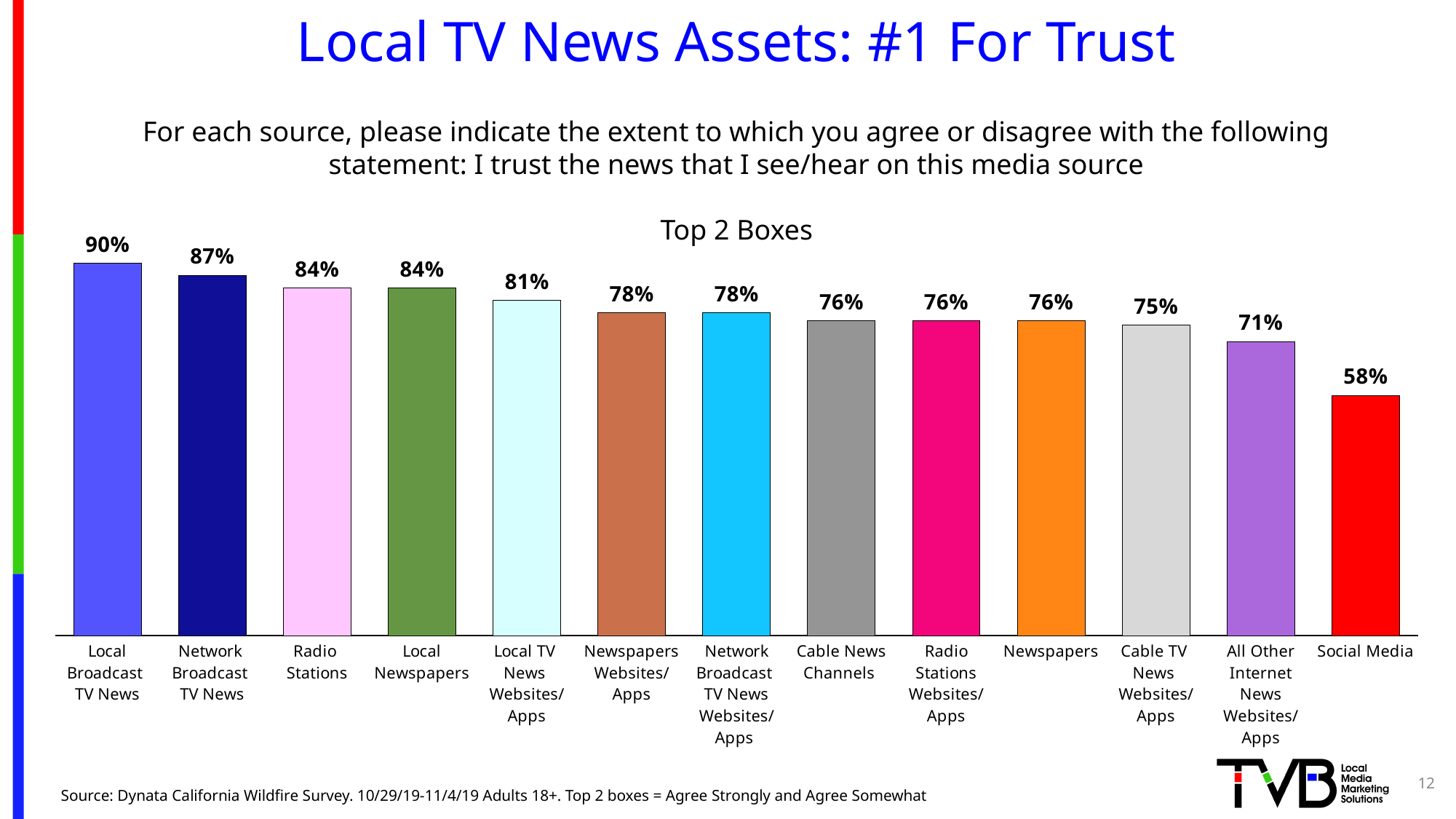
What kind of chart is shown on the slide? bar chart What is the value for All Other Internet News Websites/Apps? 71% Which is larger, Radio Stations or Newspapers Websites/Apps? Radio Stations What is the title shown above the chart? Top 2 Boxes What is the value for Social Media? 58% What is the difference between Network Broadcast TV News and Local TV News Websites/Apps? 6% How many categories are shown in the chart? 13 Which category has the highest value? Local Broadcast TV News What is the value for Cable TV News Websites/Apps? 75% What is the value for Local Broadcast TV News? 90% What is the difference between Local Broadcast TV News and Social Media? 32% Which category has the lowest value? Social Media